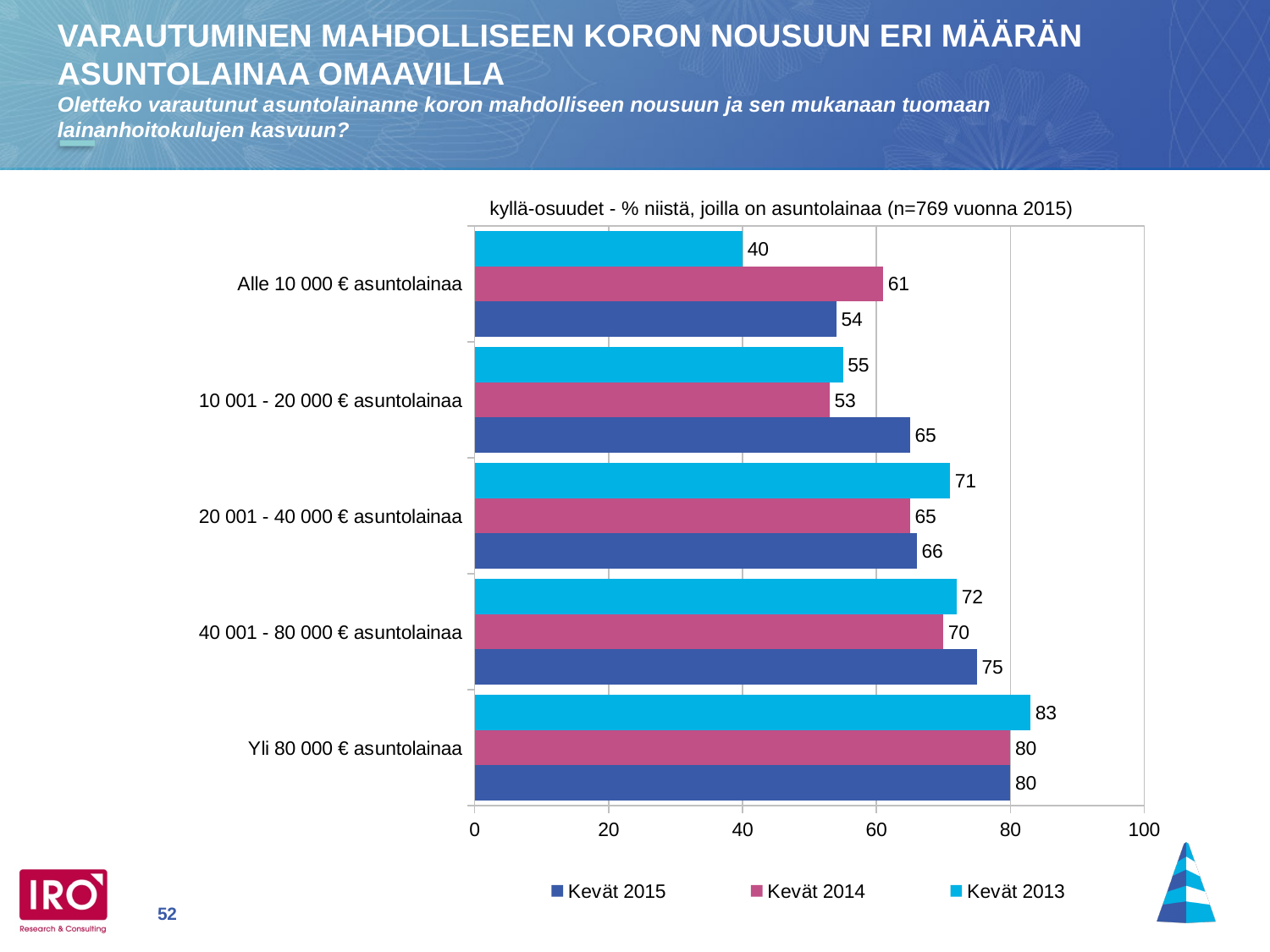
What is the value for Kevät 2014 in the '10 001 - 20 000 € asuntolainaa' category? 53 Is the value for Kevät 2013 in the '20 001 - 40 000 € asuntolainaa' category greater or less than 60? greater What is the title shown above the chart? kyllä-osuudet - % niistä, joilla on asuntolainaa (n=769 vuonna 2015) How many loan-size categories are shown on the chart? 5 Which category has the highest value for Kevät 2015? Yli 80 000 € asuntolainaa What is the value for Kevät 2015 in the 'Alle 10 000 € asuntolainaa' category? 54 How many series does the legend list? 3 What is the value for Kevät 2013 in the 'Yli 80 000 € asuntolainaa' category? 83 What kind of chart is shown on the slide? bar chart What is the difference between the Kevät 2014 and Kevät 2013 values in the 'Alle 10 000 € asuntolainaa' category? 21 In the '40 001 - 80 000 € asuntolainaa' category, which is larger: the Kevät 2015 value or the Kevät 2014 value? Kevät 2015 Which category has the lowest value for Kevät 2013? Alle 10 000 € asuntolainaa